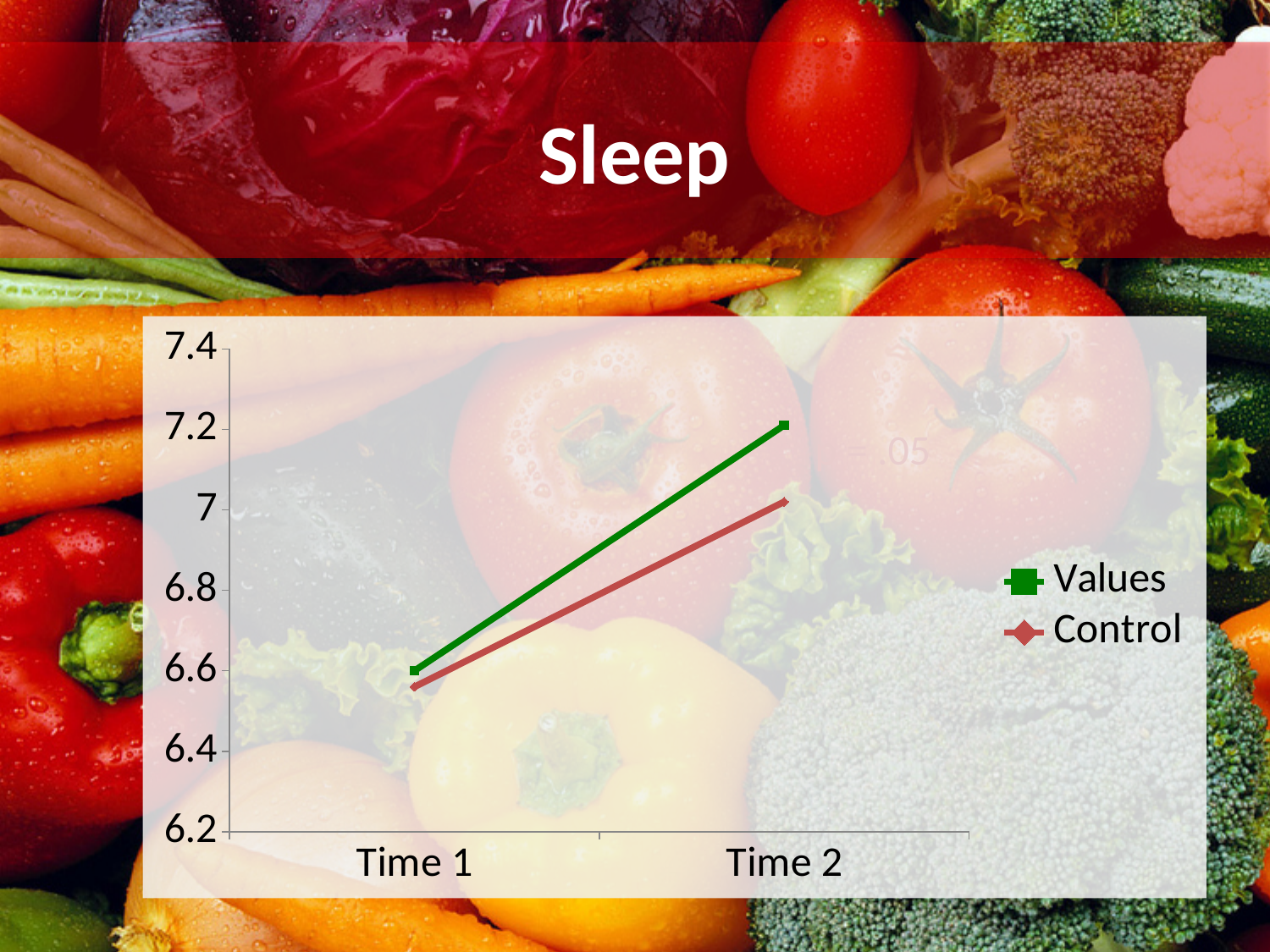
How many time points are shown on the x axis? 2 What is the title of the slide containing the chart? Sleep Does the Values series rise or fall from Time 1 to Time 2? rise Does the Control series rise or fall from Time 1 to Time 2? rise Is the value for Control at Time 2 greater or less than 6.8? greater At Time 2, which series has the higher value, Values or Control? Values Is the value for Control at Time 1 greater or less than 6.4? greater Is the value for Values at Time 2 greater or less than 7.4? less What kind of chart is shown on the slide? line chart What colour is the line for the Values series? green How many series does the legend list? 2